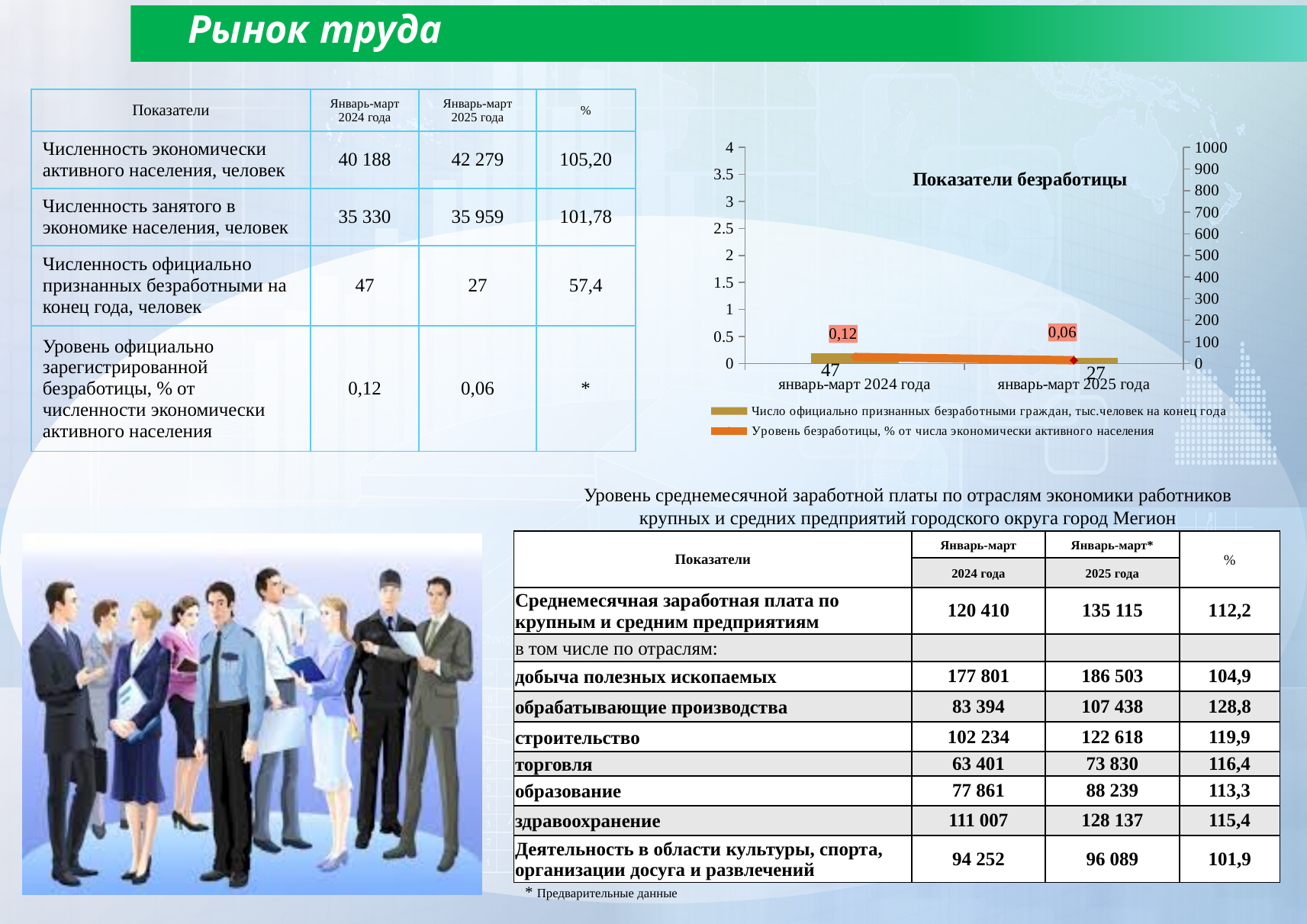
In the chart 'Показатели безработицы', what is the number of officially recognised unemployed citizens for январь-март 2025 года? 27 In the chart 'Показатели безработицы', by how much did the number of officially recognised unemployed citizens fall from январь-март 2024 года to январь-март 2025 года? 20 In the chart 'Показатели безработицы', which period has the lower unemployment rate? январь-март 2025 года In the chart 'Показатели безработицы', what is the unemployment rate (% of economically active population) for январь-март 2024 года? 0,12 In the chart 'Показатели безработицы', does the unemployment rate rise or fall from январь-март 2024 года to январь-март 2025 года? fall In the chart 'Показатели безработицы', how many series does the legend list? 2 In the chart 'Показатели безработицы', what is the unemployment rate (% of economically active population) for январь-март 2025 года? 0,06 In the chart 'Показатели безработицы', which period has the higher number of officially recognised unemployed citizens? январь-март 2024 года In the chart 'Показатели безработицы', what is the number of officially recognised unemployed citizens for январь-март 2024 года? 47 In the chart 'Показатели безработицы', how many periods are shown on the x axis? 2 In the chart 'Показатели безработицы', is the unemployment rate for январь-март 2024 года larger or smaller than for январь-март 2025 года? larger In the chart 'Показатели безработицы', what is the difference between the unemployment rate for январь-март 2024 года and for январь-март 2025 года? 0,06